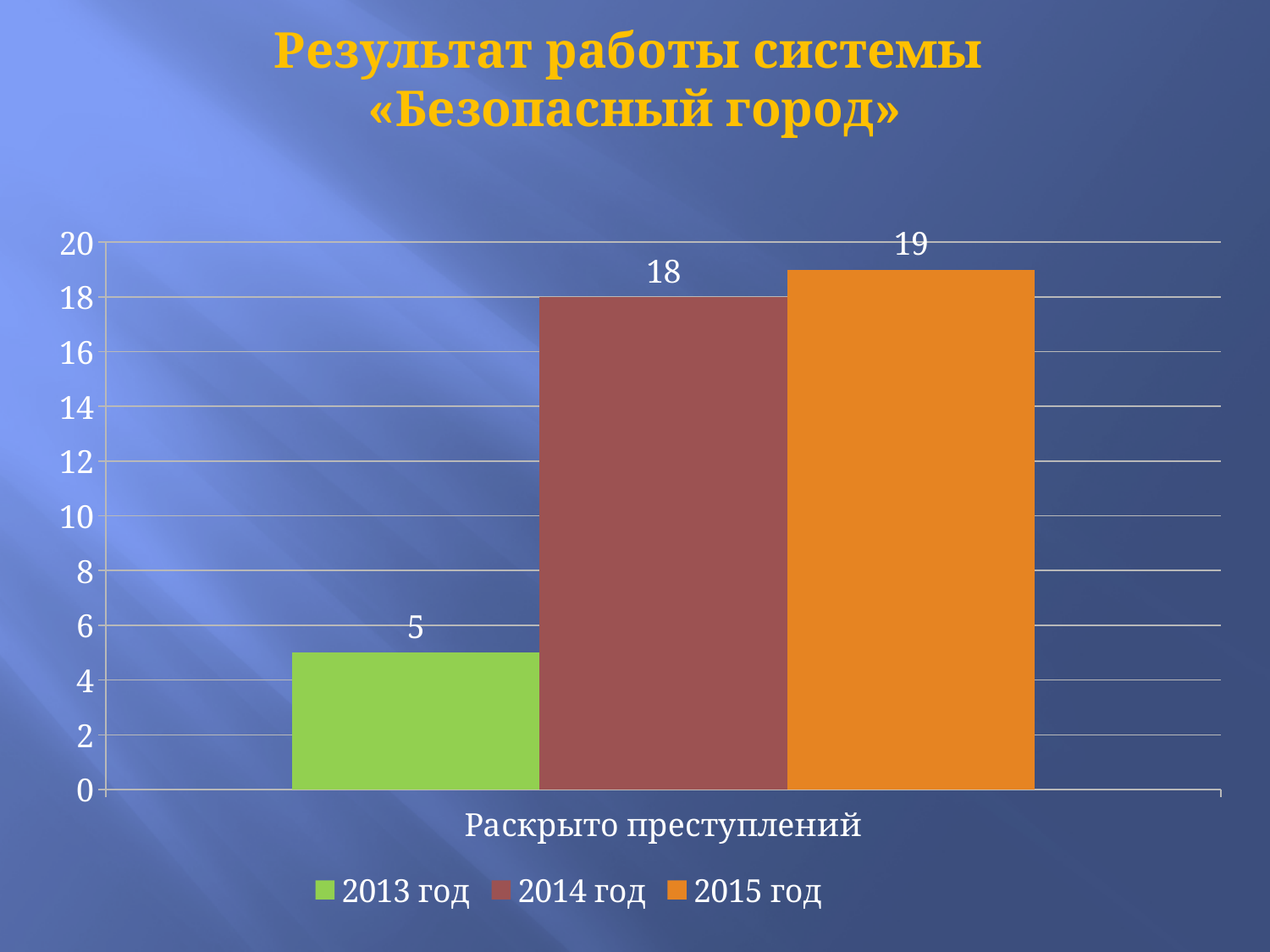
Is the value for 2013 год greater or less than 10? less What kind of chart is shown on the slide? bar chart How many series does the legend list? 3 Which is larger, the value for 2013 год or the value for 2014 год? 2014 год What is the value for 2014 год in the chart? 18 Which series has the highest value? 2015 год What is the difference between the values for 2014 год and 2013 год? 13 What is the value for 2015 год in the chart? 19 Which series has the lowest value? 2013 год What is the difference between the values for 2015 год and 2014 год? 1 What is the category label shown on the x axis? Раскрыто преступлений What is the value for 2013 год in the chart? 5